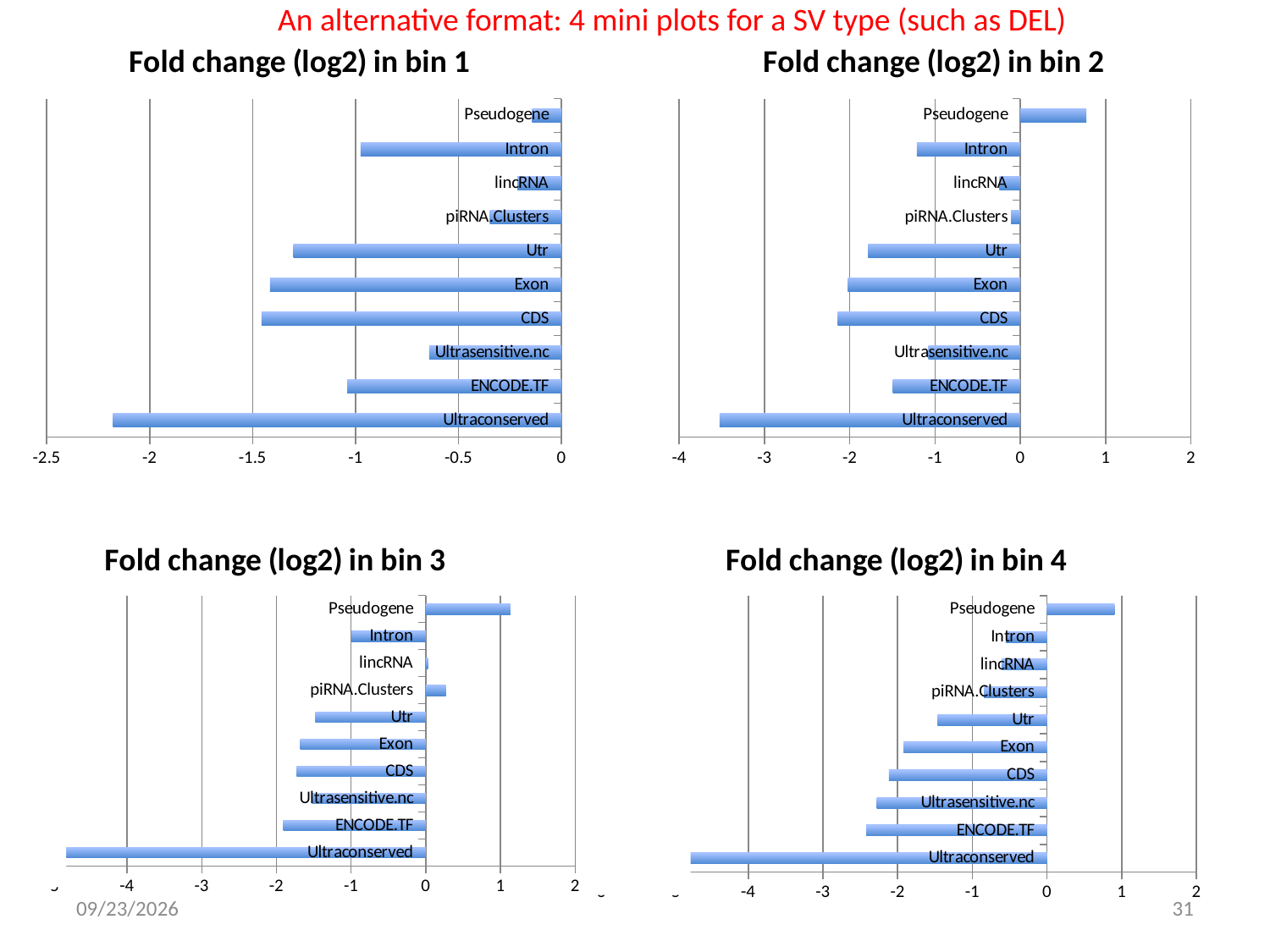
How many categories are plotted in the 'Fold change (log2) in bin 3' chart? 10 In the 'Fold change (log2) in bin 4' chart, which category has the lowest value? Ultraconserved How many charts are shown on the slide? 4 In the 'Fold change (log2) in bin 4' chart, is the value for CDS greater or less than -1? less In the 'Fold change (log2) in bin 3' chart, is the value for Ultraconserved greater or less than -4? less In the 'Fold change (log2) in bin 1' chart, is the value for Intron greater or less than -0.5? less What kind of chart is 'Fold change (log2) in bin 4'? bar chart In the 'Fold change (log2) in bin 2' chart, which has the larger value, Intron or Exon? Intron In the 'Fold change (log2) in bin 2' chart, which category has the highest value? Pseudogene In the 'Fold change (log2) in bin 1' chart, which category has the lowest value? Ultraconserved